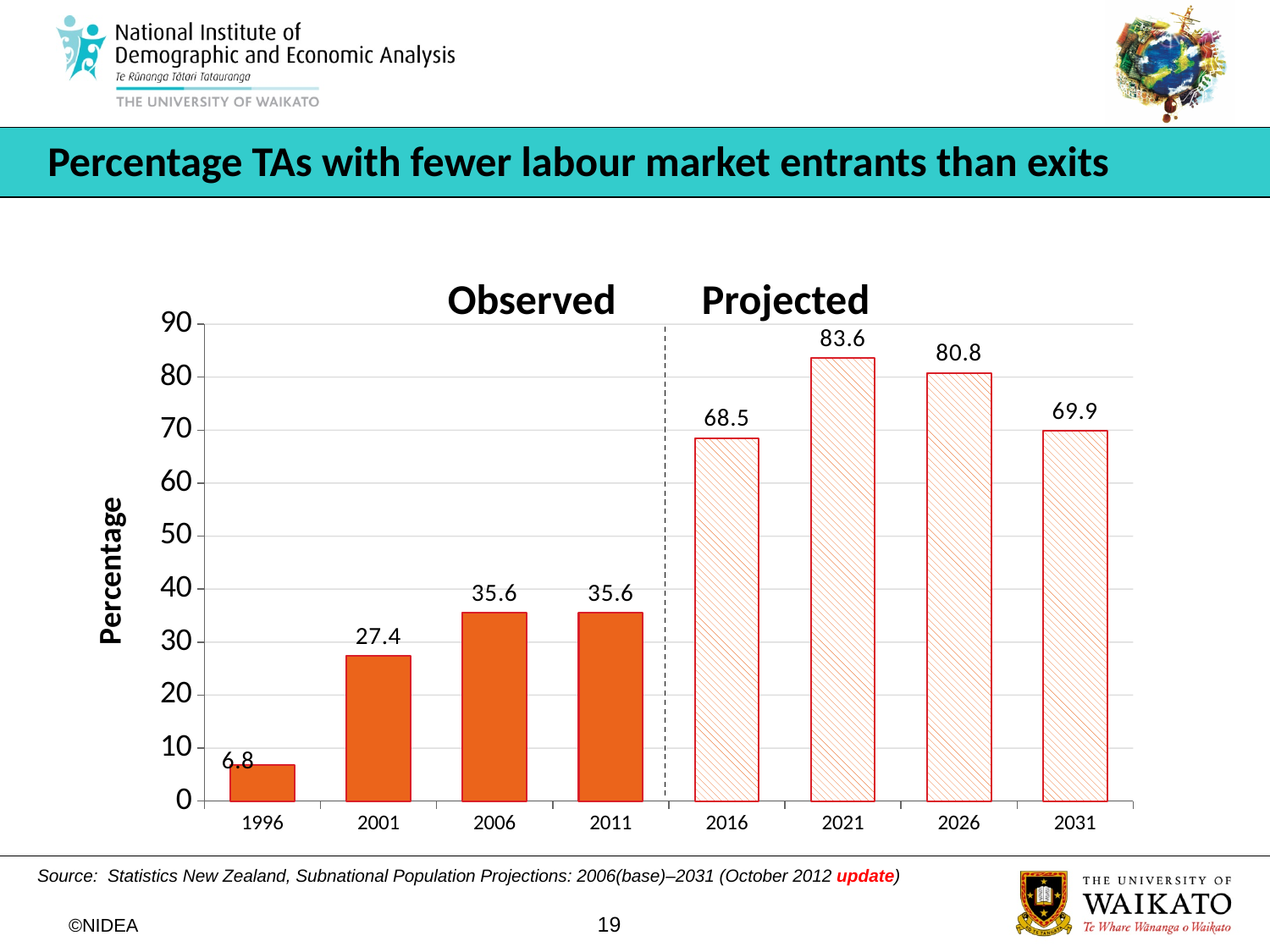
How many years are shown on the x axis? 8 Which year has the highest value? 2021 What is the difference between the values for 2021 and 2026? 2.8 Which is larger, the value for 2001 or the value for 2031? 2031 What is the label on the y axis? Percentage What is the value for 2031? 69.9 What is the value for 2016? 68.5 Which year has the lowest value? 1996 Is the value for 2026 greater or less than 80? greater What kind of chart is this? bar chart What is the difference between the values for 2011 and 2016? 32.9 What is the value for 1996? 6.8